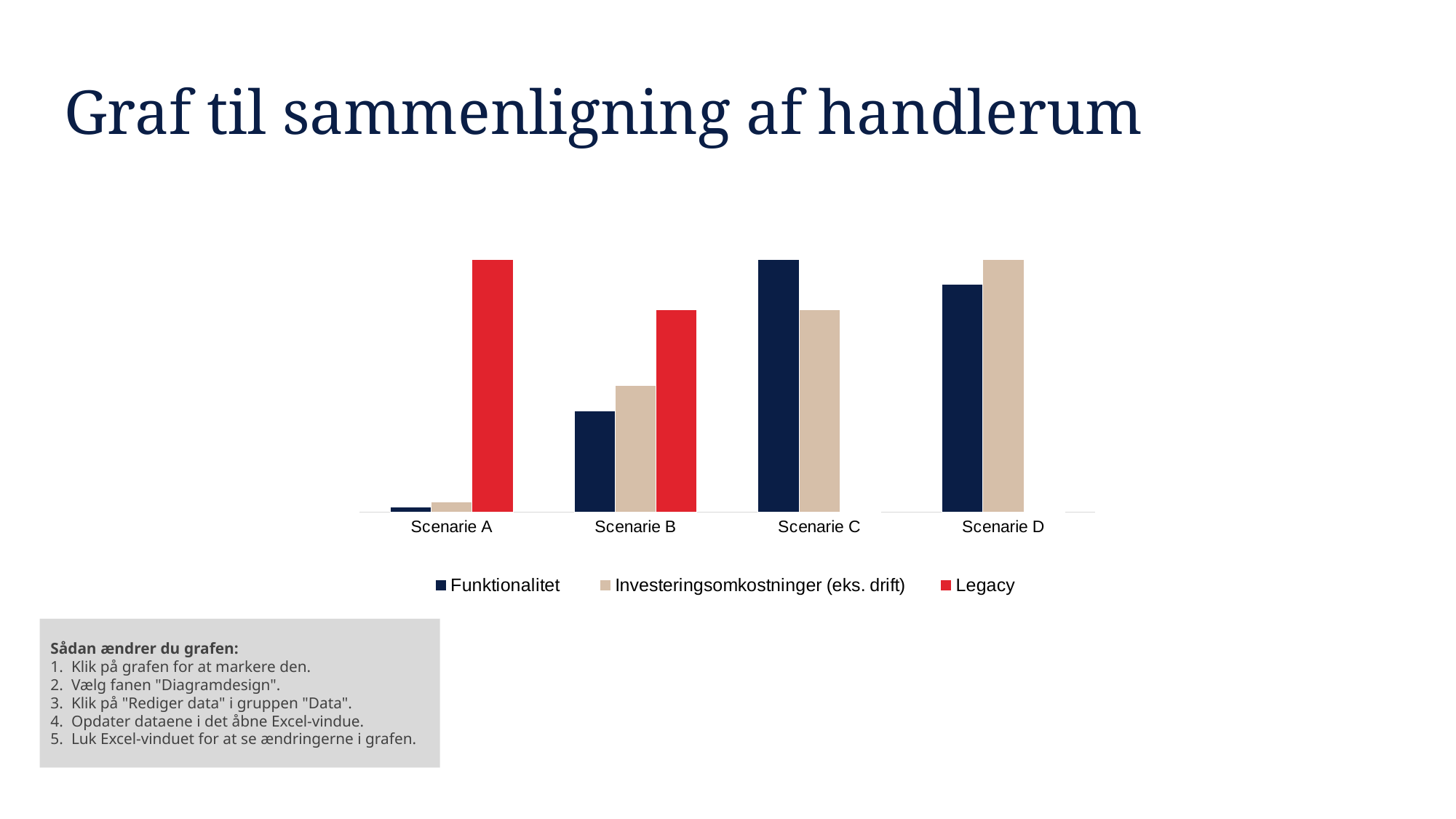
Which scenario has the lowest Investeringsomkostninger (eks. drift) bar? Scenarie A In Scenarie C, which is larger: Funktionalitet or Investeringsomkostninger (eks. drift)? Funktionalitet Which scenario has the highest Funktionalitet bar? Scenarie C What kind of chart is shown on the slide? bar chart Which colour represents the Legacy series in the chart's legend? red How many series does the chart's legend list? 3 Which scenario has the lowest Funktionalitet bar? Scenarie A Which scenario has the highest Investeringsomkostninger (eks. drift) bar? Scenarie D For Legacy, which is larger: Scenarie A or Scenarie B? Scenarie A How many scenarios are shown on the x axis of the chart? 4 In Scenarie B, which is larger: Funktionalitet or Investeringsomkostninger (eks. drift)? Investeringsomkostninger (eks. drift) Do the Investeringsomkostninger (eks. drift) values rise or fall from Scenarie A to Scenarie D? rise